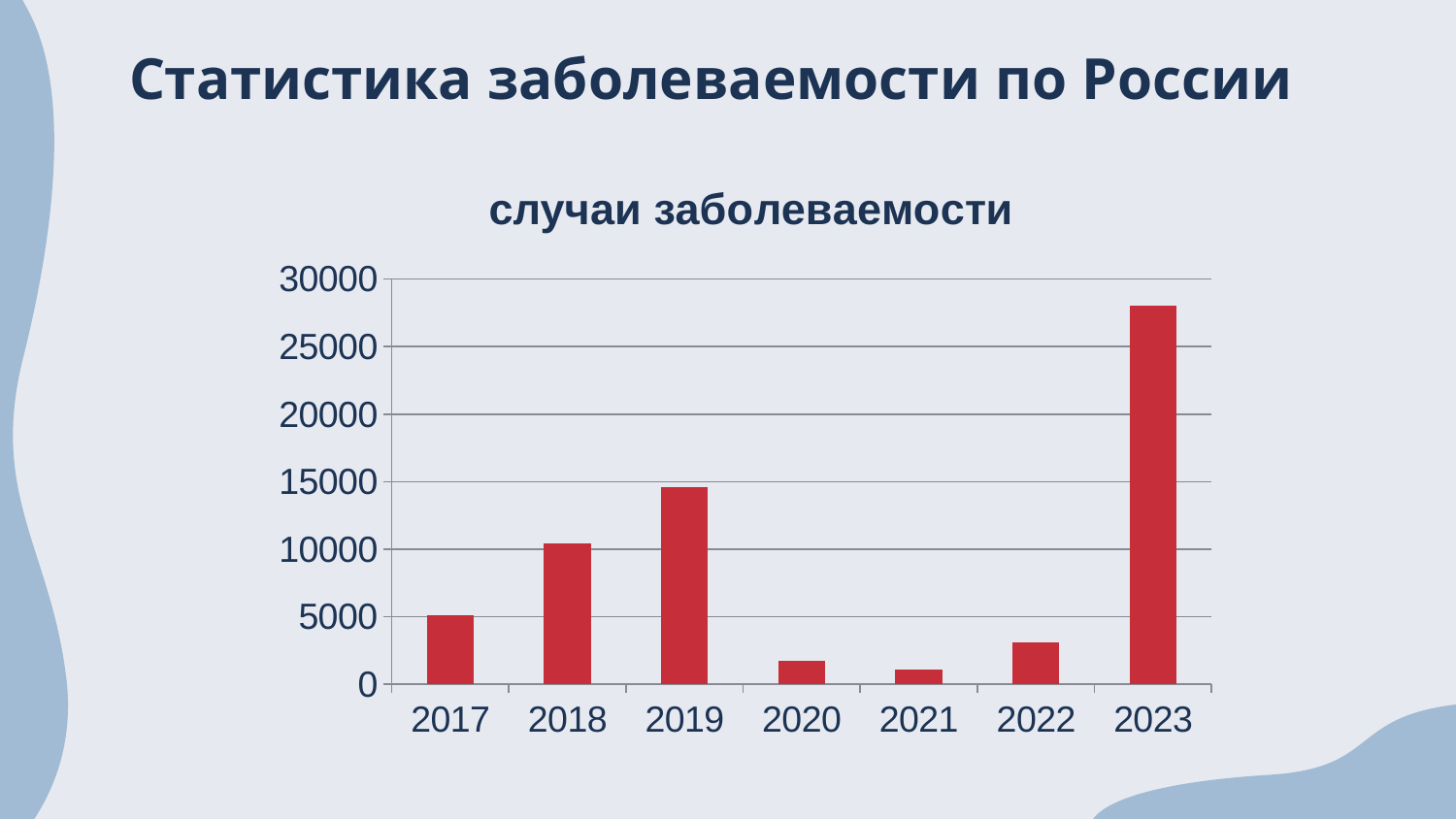
Which is larger, the value for 2018 or the value for 2019? 2019 Which year has the highest value in the chart? 2023 What is the title of the chart? случаи заболеваемости Is the value for 2023 greater or less than 25000? greater Do the values rise or fall from 2017 to 2019? rise What kind of chart is shown on the slide? bar chart Which year has the lowest value in the chart? 2021 How many years are shown on the x axis of the chart? 7 Is the value for 2020 greater or less than 5000? less Which is larger, the value for 2022 or the value for 2021? 2022